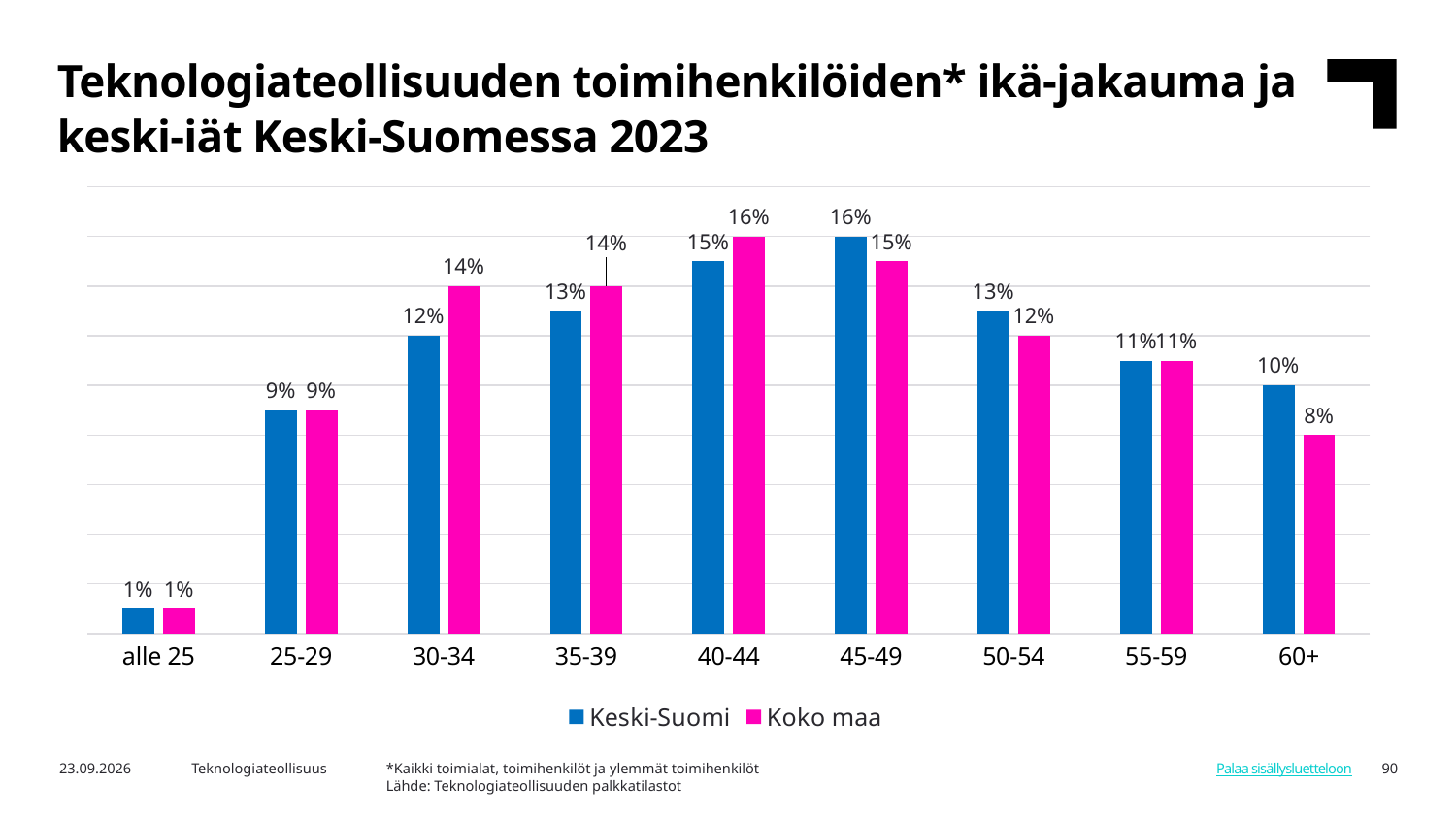
Which age group has the lowest Keski-Suomi value? alle 25 What is the difference between the Keski-Suomi and Koko maa values for the 60+ age group? 2% For the 50-54 age group, which series has the larger value, Keski-Suomi or Koko maa? Keski-Suomi What is the Koko maa value for the 30-34 age group? 14% What is the Keski-Suomi value for the 45-49 age group? 16% For the 30-34 age group, which series has the larger value, Keski-Suomi or Koko maa? Koko maa What kind of chart is shown on the slide? Bar chart What is the Koko maa value for the 60+ age group? 8% Which age group has the highest Keski-Suomi value? 45-49 Which age group has the highest Koko maa value? 40-44 How many age groups are shown on the x axis? 9 How many series does the legend list? 2